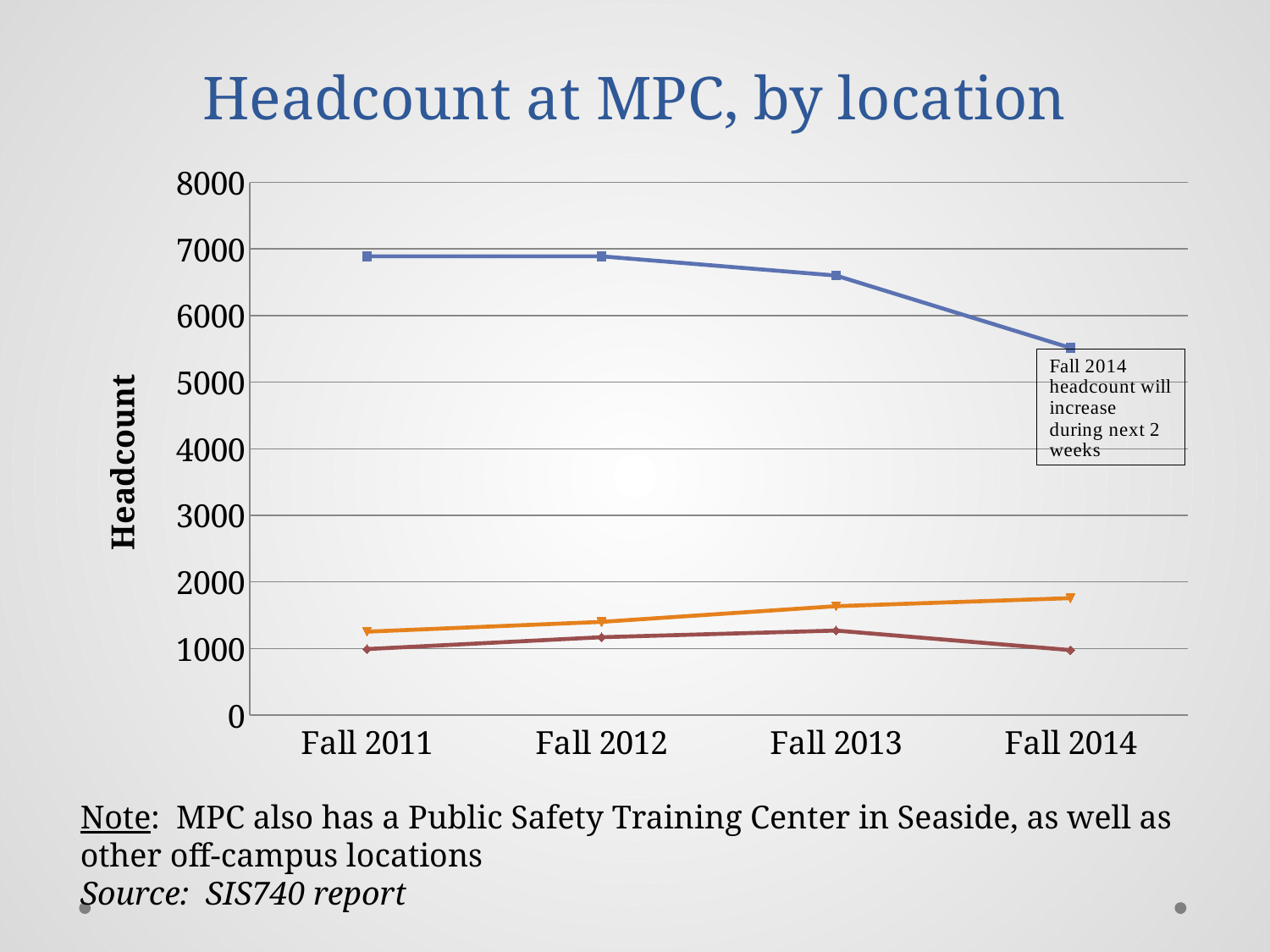
How many lines are plotted on the chart? 3 Does the orange line rise or fall from Fall 2011 to Fall 2014? rise In which period is the orange line at its lowest? Fall 2011 In which period is the blue line at its lowest? Fall 2014 Is the value of the blue line for Fall 2014 greater or less than 5000? greater How many time periods are shown along the x axis? 4 What is the title of the chart? Headcount at MPC, by location Which line has the higher value in Fall 2014, the orange line or the red line? orange line What is the label on the vertical axis of the chart? Headcount Does the blue line rise or fall from Fall 2011 to Fall 2014? fall What kind of chart is shown on the slide? line chart